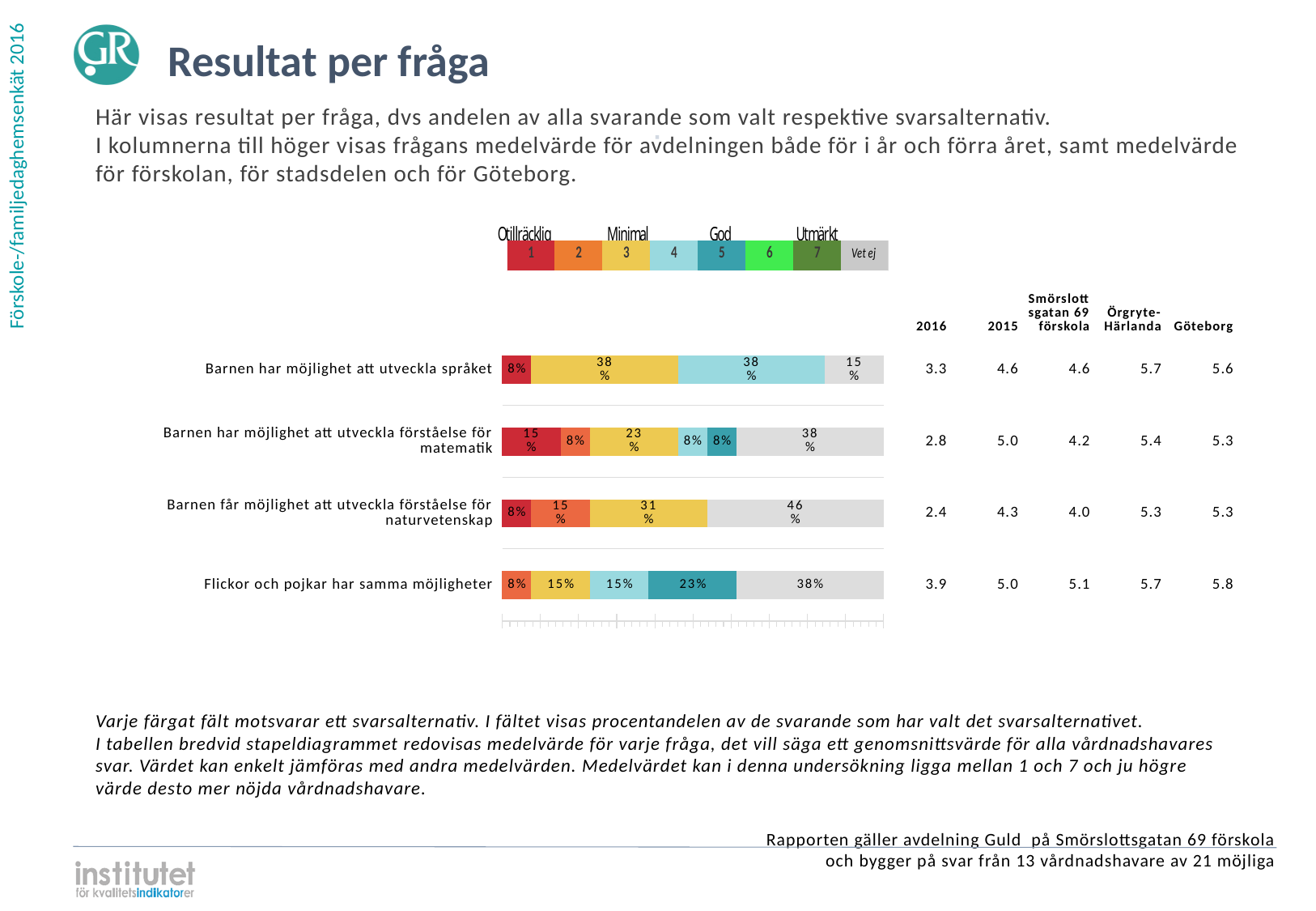
What percentage of respondents chose 'Vet ej' for 'Barnen får möjlighet att utveckla förståelse för naturvetenskap'? 46% What label does the legend give to answer alternative 7? Utmärkt What kind of chart is shown on the slide? Stacked bar chart How many questions (categories) are plotted in the bar chart? 4 Which question has the largest 'Vet ej' (grey) share? Barnen får möjlighet att utveckla förståelse för naturvetenskap What is the difference between the 'Vet ej' share for 'Barnen får möjlighet att utveckla förståelse för naturvetenskap' (46%) and for 'Barnen har möjlighet att utveckla språket' (15%)? 31 percentage points Which question has the smallest 'Vet ej' (grey) share? Barnen har möjlighet att utveckla språket What is the 2016 mean value shown for 'Flickor och pojkar har samma möjligheter'? 3.9 What percentage of respondents chose answer alternative 5 (teal) for 'Flickor och pojkar har samma möjligheter'? 23% What percentage of respondents chose answer alternative 1 (red) for 'Barnen har möjlighet att utveckla förståelse för matematik'? 15% How many answer alternatives does the legend above the chart list? 8 Which is larger: the yellow (alternative 3) share for 'Barnen har möjlighet att utveckla språket' or for 'Barnen får möjlighet att utveckla förståelse för naturvetenskap'? Barnen har möjlighet att utveckla språket